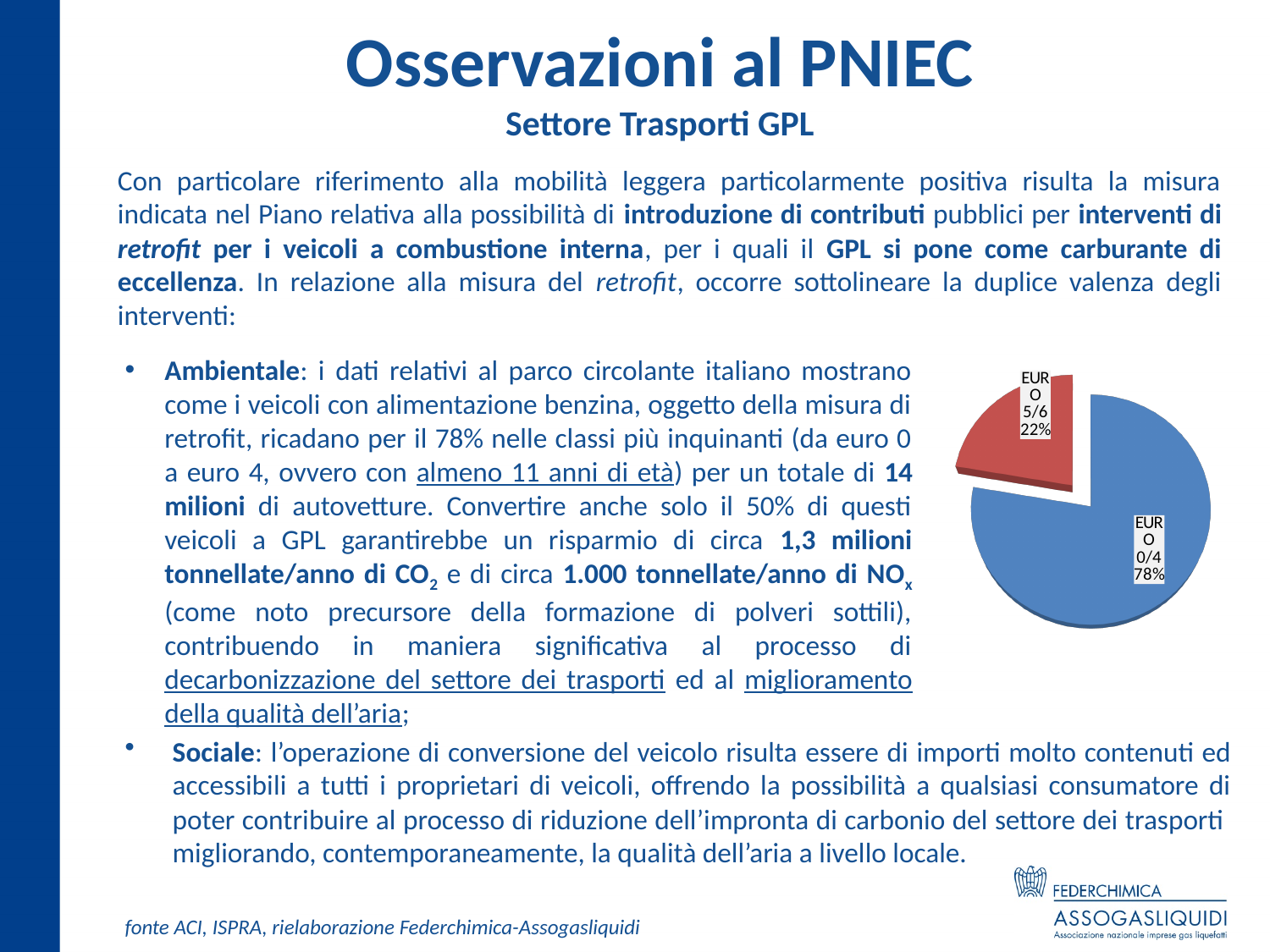
What colour is the EURO 0/4 slice in the pie chart? blue What share of the pie does the EURO 0/4 slice represent? 78% What is the difference in percentage points between the EURO 0/4 slice and the EURO 5/6 slice? 56 Which slice of the pie chart is the largest? EURO 0/4 What share of the pie does the EURO 5/6 slice represent? 22% How many slices does the pie chart have? 2 What colour is the EURO 5/6 slice in the pie chart? red What kind of chart is shown on the slide? pie chart Which slice of the pie chart is the smallest? EURO 5/6 Which is larger in the pie chart, the EURO 0/4 slice or the EURO 5/6 slice? EURO 0/4 What is the total of the two percentages shown in the pie chart? 100%